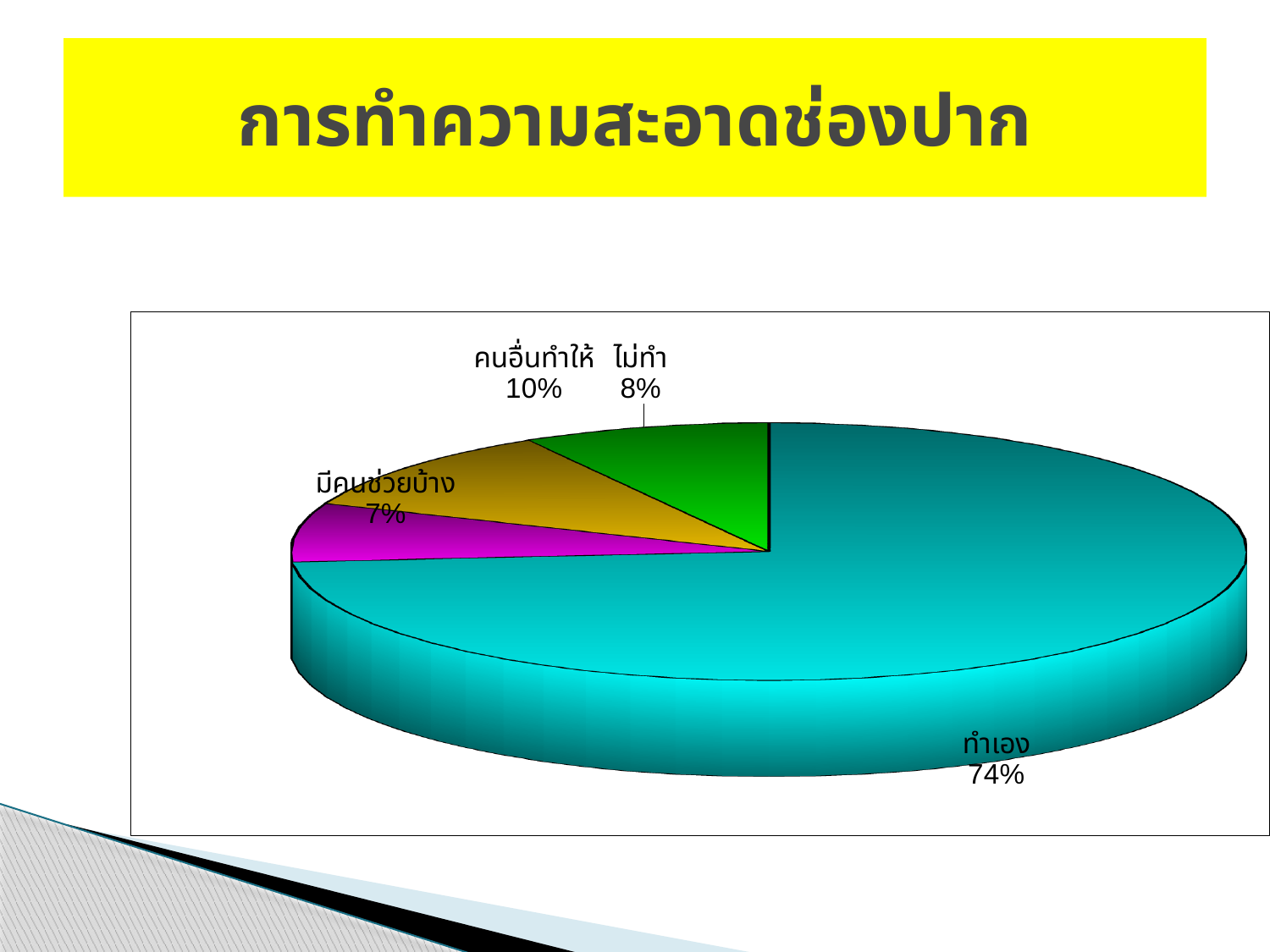
What percentage is shown for ไม่ทำ? 8% Which category has the largest slice of the pie? ทำเอง What percentage is shown for ทำเอง? 74% What is the difference in percentage points between ทำเอง and คนอื่นทำให้? 64% What percentage is shown for คนอื่นทำให้? 10% Which category has the smallest slice of the pie? มีคนช่วยบ้าง Which is larger, the slice for คนอื่นทำให้ or the slice for ไม่ทำ? คนอื่นทำให้ What kind of chart is shown on the slide? Pie chart How many slices does the pie chart have? 4 What colour is the slice for ทำเอง? Teal What is the title of the slide above the chart? การทำความสะอาดช่องปาก What percentage is shown for มีคนช่วยบ้าง? 7%